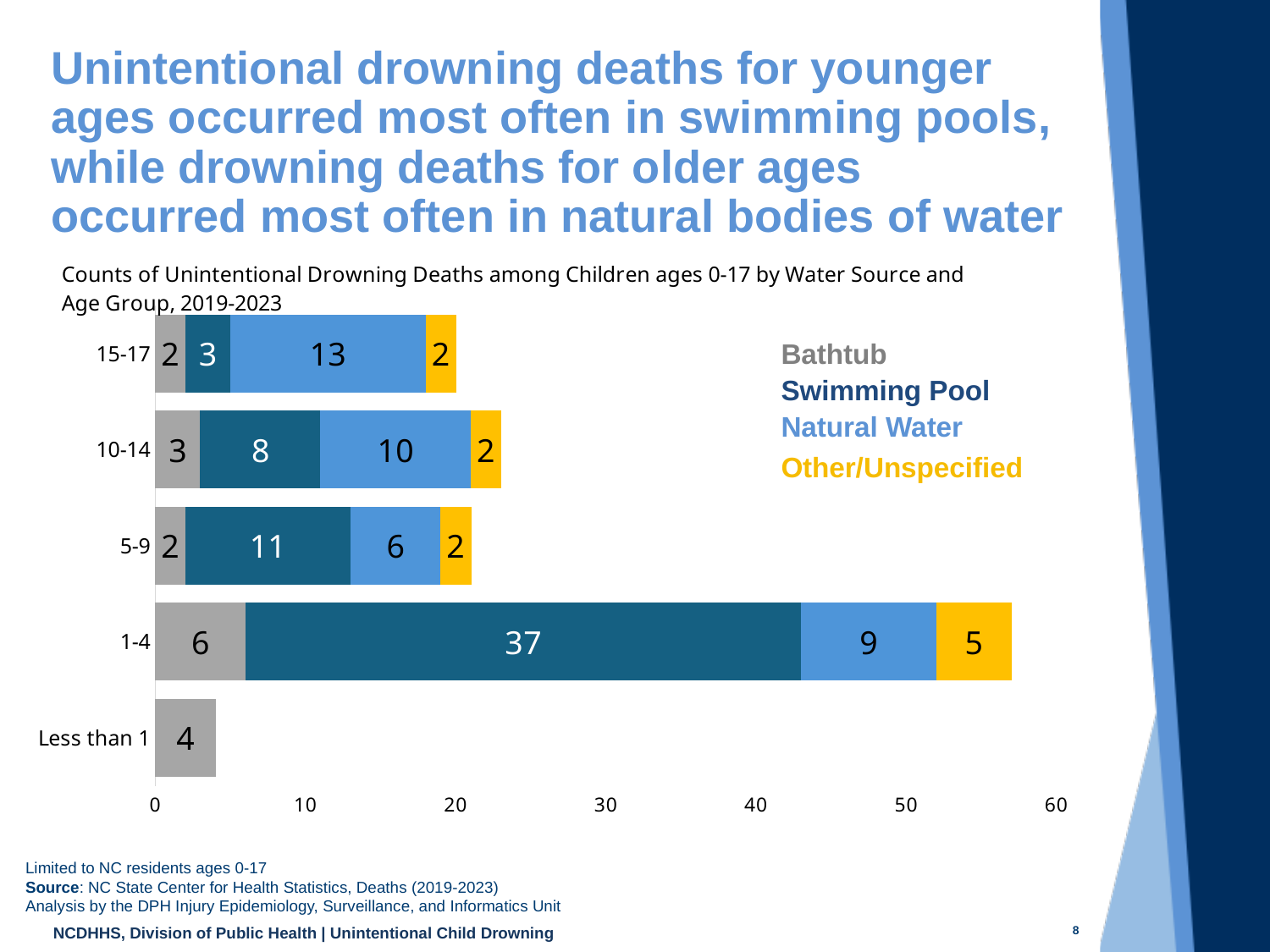
Which age group has the lowest total number of drowning deaths? Less than 1 Which age group has the highest total number of drowning deaths? 1-4 What kind of chart is shown on the slide? Stacked bar chart What is the total number of drowning deaths for the 1-4 age group? 57 What is the Natural Water count for the 15-17 age group? 13 Which is larger for the 10-14 age group: the Swimming Pool count or the Natural Water count? Natural Water What is the difference between the Swimming Pool count for the 5-9 age group and the Swimming Pool count for the 10-14 age group? 3 What is the Swimming Pool count for the 1-4 age group? 37 What is the Bathtub count for the Less than 1 age group? 4 How many age groups are shown on the chart? 5 How many series does the legend list? 4 What is the total number of drowning deaths for the 10-14 age group? 23